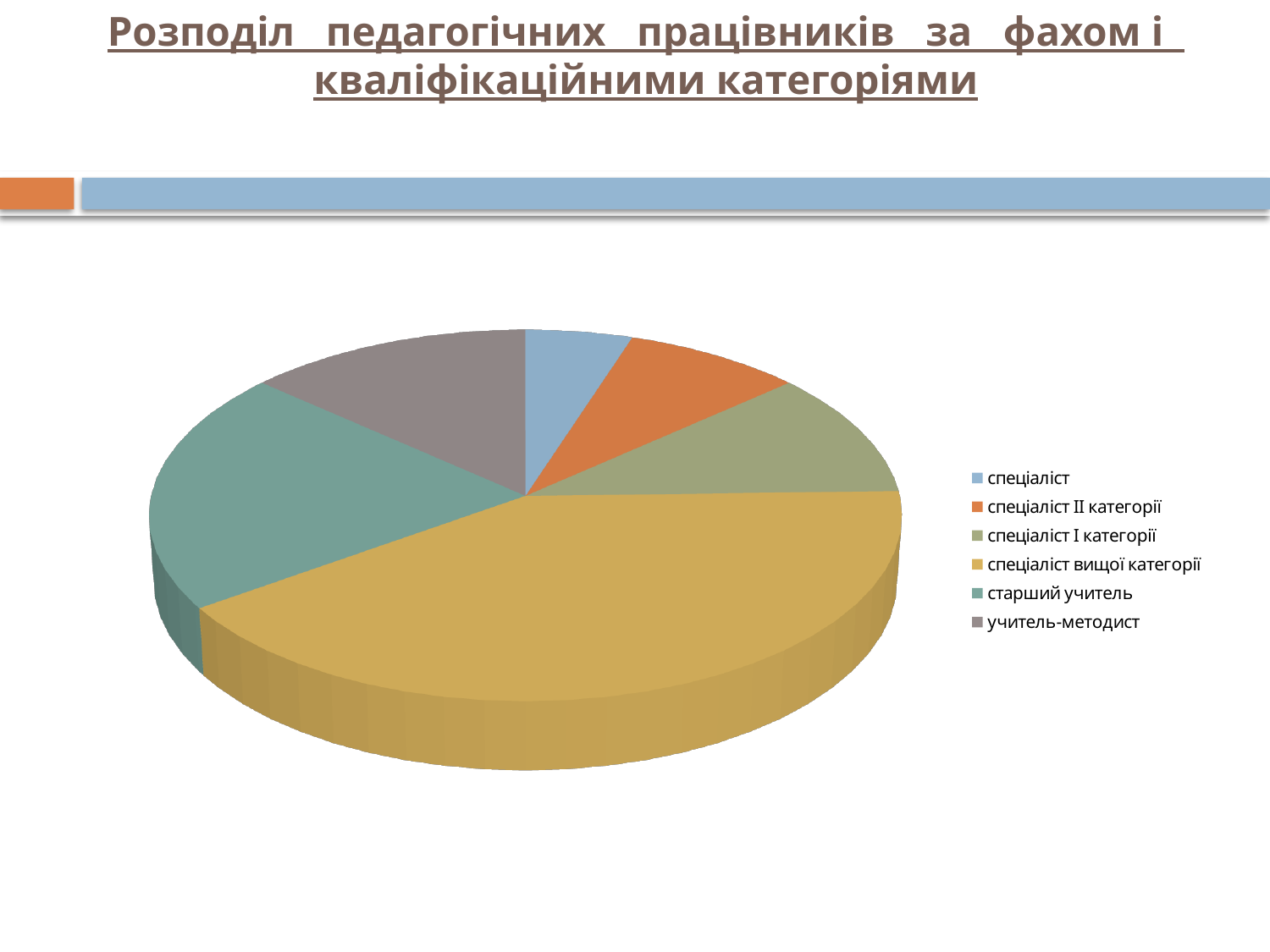
Which slice is larger: старший учитель or спеціаліст I категорії? старший учитель Which slice is larger: спеціаліст вищої категорії or старший учитель? спеціаліст вищої категорії What is the title of the slide containing the pie chart? Розподіл педагогічних працівників за фахом і кваліфікаційними категоріями How many entries does the legend of the pie chart list? 6 What kind of chart is shown on the slide? pie chart Which category has the largest slice of the pie? спеціаліст вищої категорії Which slice is larger: старший учитель or учитель-методист? старший учитель How many categories (slices) does the pie chart have? 6 What colour is the slice for спеціаліст вищої категорії? yellow (gold)